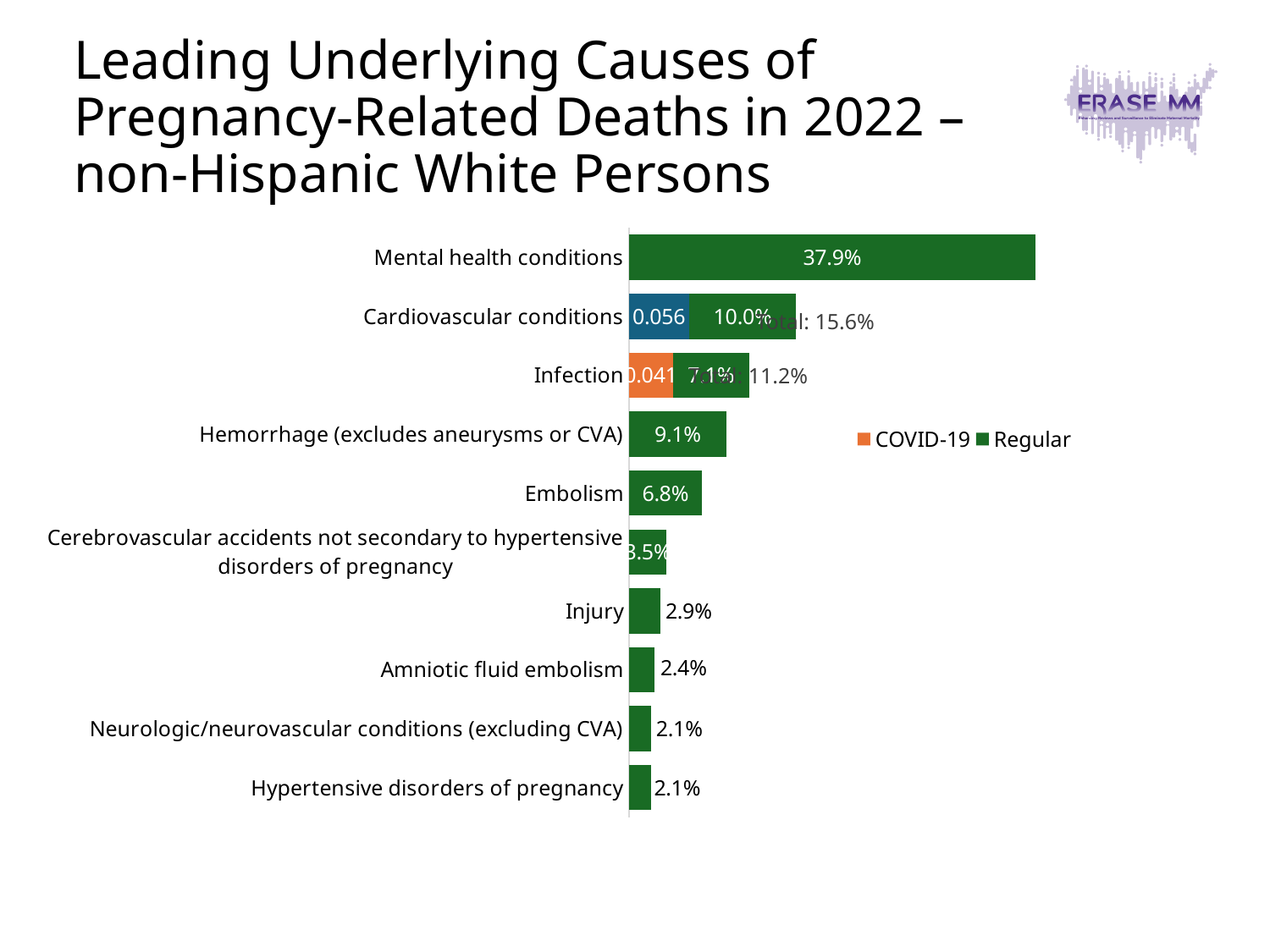
What is the total shown for Cardiovascular conditions? 15.6% What is the value shown for Embolism? 6.8% How many categories (causes of death) are listed on the chart? 10 Which is larger, the value for Hemorrhage (excludes aneurysms or CVA) or the value for Embolism? Hemorrhage (excludes aneurysms or CVA) What is the value shown for Amniotic fluid embolism? 2.4% What is the value shown for Injury? 2.9% Which category has the highest value on the chart? Mental health conditions What is the value shown for Hemorrhage (excludes aneurysms or CVA)? 9.1% What are the two series named in the legend? COVID-19 and Regular How many series does the legend list? 2 What is the value shown for Mental health conditions? 37.9% What type of chart is shown on the slide? bar chart